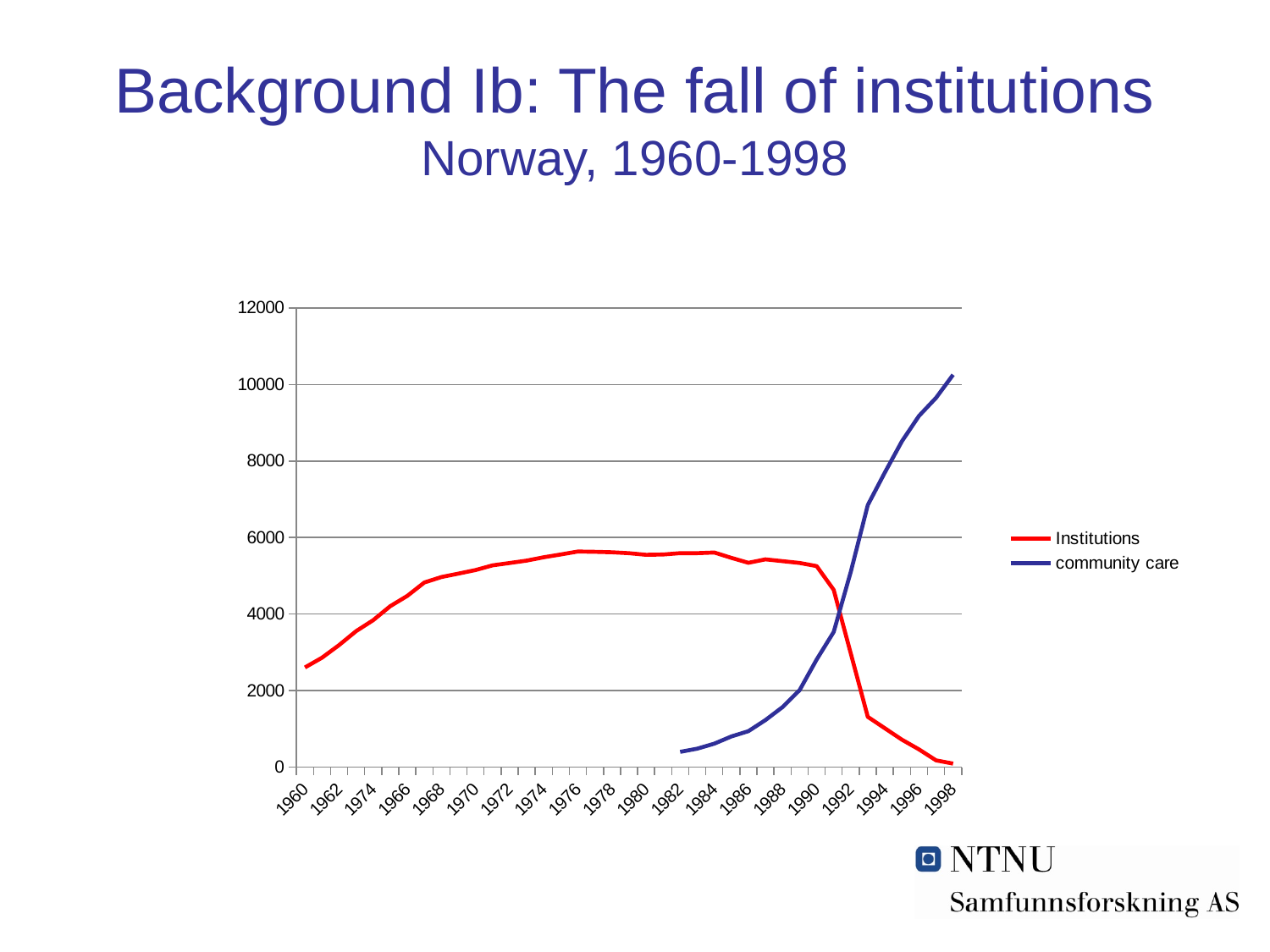
Is the value for community care in 1982 greater or less than 2000? less Is the value for Institutions in 1976 greater or less than 6000? less In 1998, which series has the larger value, Institutions or community care? community care Which series is drawn in red? Institutions In 1984, which series has the larger value, Institutions or community care? Institutions Does the community care series rise or fall from 1982 to 1998? rise Is the value for Institutions in 1960 greater or less than 2000? greater Which series is drawn in blue? community care What kind of chart is shown on the slide? line chart How many series does the legend list? 2